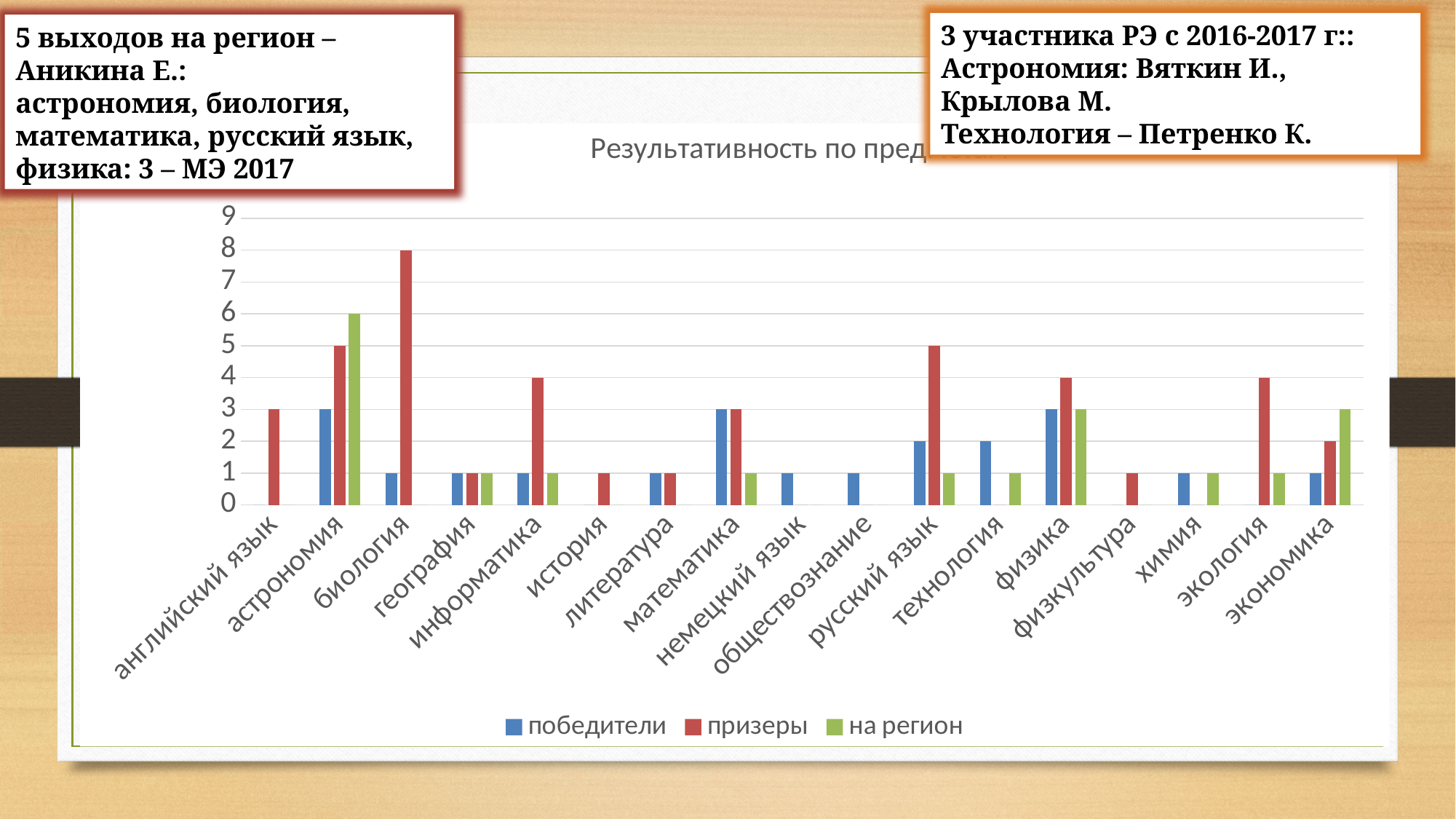
Is the value for призеры for биология greater or less than 5? greater What is the difference between призеры and победители for русский язык? 3 Which is larger for экология: призеры or на регион? призеры What kind of chart is shown on the slide? bar chart Which subject has the highest value for призеры? биология What is the value for победители for физика? 3 What is the value for призеры for биология? 8 Which subject has the highest value for на регион? астрономия How many subject categories are shown on the x axis of the chart? 17 What is the value for на регион for астрономия? 6 How many series does the chart legend list? 3 Which series in the legend is shown in green? на регион